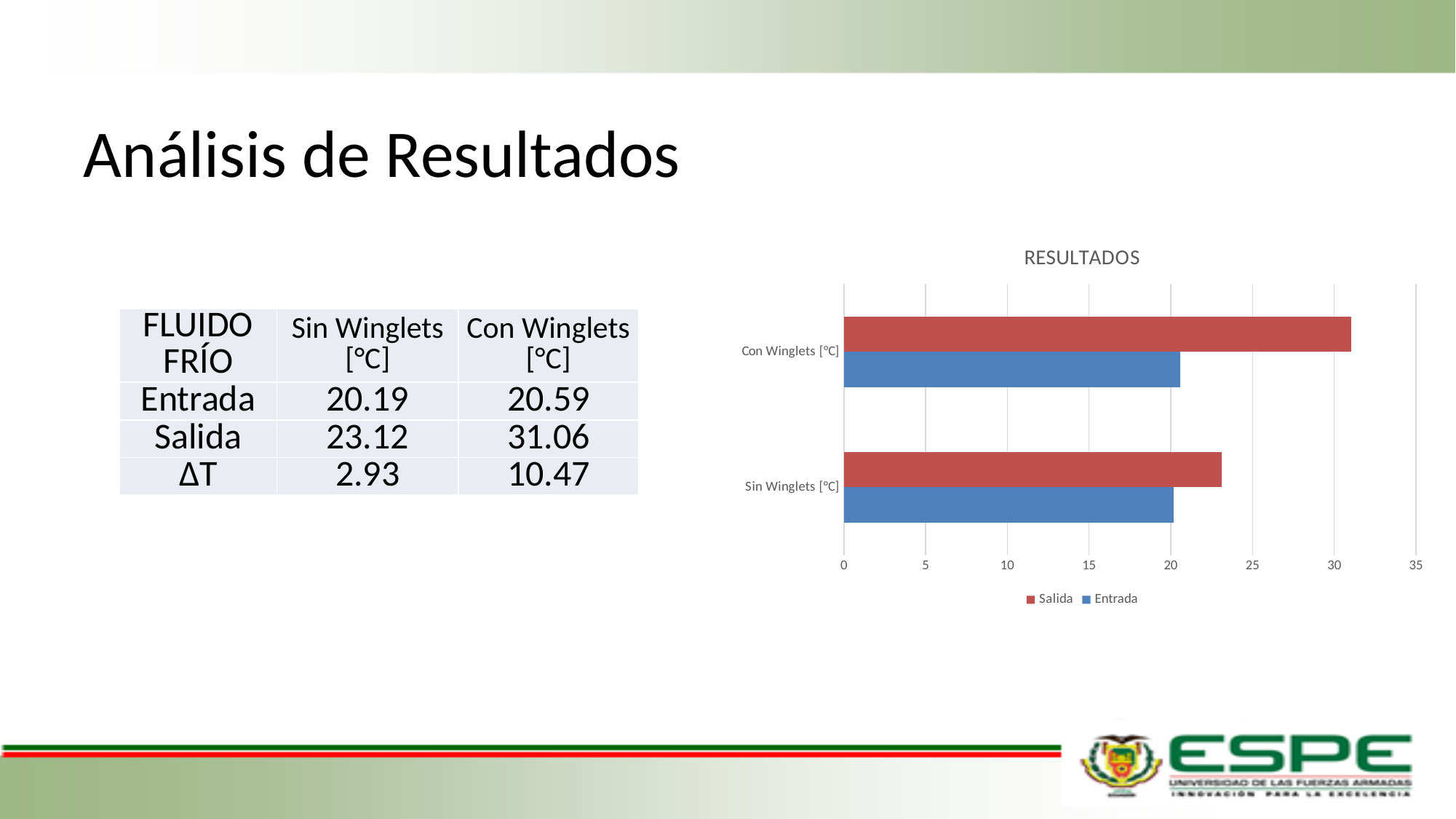
According to the slide, what is the Entrada temperature for Sin Winglets [°C]? 20.19 What kind of chart is shown under the title RESULTADOS? bar chart How many series does the legend of the RESULTADOS chart list? 2 In the RESULTADOS chart, is the Salida value for Sin Winglets [°C] greater or less than 25? less In the RESULTADOS chart, is the Salida value for Con Winglets [°C] greater or less than 30? greater What is the title of the chart on the slide? RESULTADOS How many categories are shown on the vertical axis of the RESULTADOS chart? 2 In the RESULTADOS chart, which bar is the longest overall? Salida for Con Winglets [°C] According to the slide, what is the Salida temperature for Con Winglets [°C]? 31.06 In the RESULTADOS chart, is the Entrada value for Sin Winglets [°C] greater or less than 15? greater In the RESULTADOS chart, which is larger: the Salida bar for Con Winglets [°C] or the Salida bar for Sin Winglets [°C]? Con Winglets [°C] Which series in the RESULTADOS chart is drawn in red? Salida